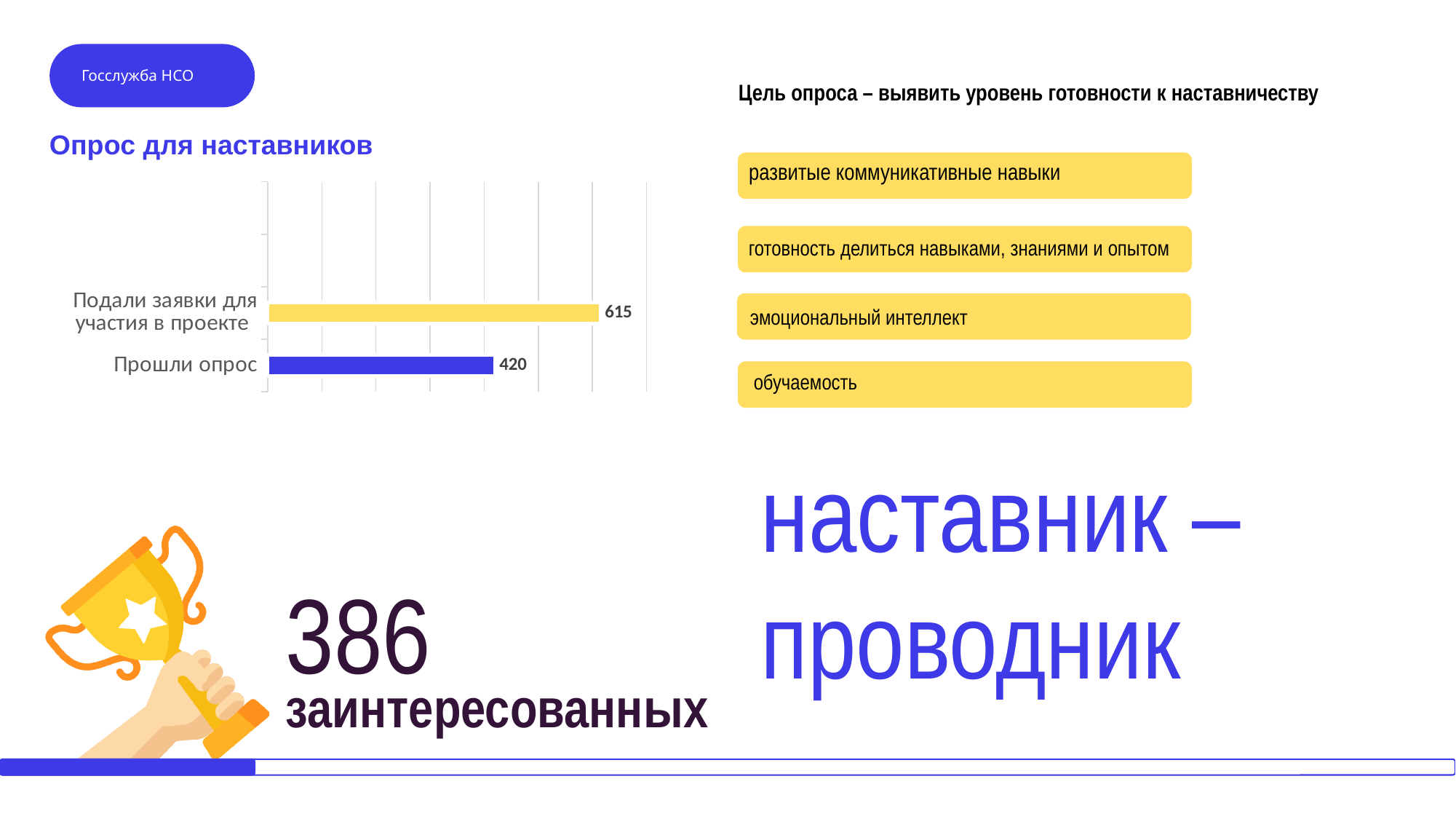
What is the difference between the value for "Подали заявки для участия в проекте" and the value for "Прошли опрос"? 195 What is the value for "Прошли опрос"? 420 How many categories are shown in the chart? 2 What is the title of the chart? Опрос для наставников What kind of chart is shown on the slide? Bar chart Which is larger: the value for "Подали заявки для участия в проекте" or the value for "Прошли опрос"? Подали заявки для участия в проекте What is the value for "Подали заявки для участия в проекте"? 615 Which category has the highest value? Подали заявки для участия в проекте What colour is the bar for "Прошли опрос"? Blue Which category has the lowest value? Прошли опрос